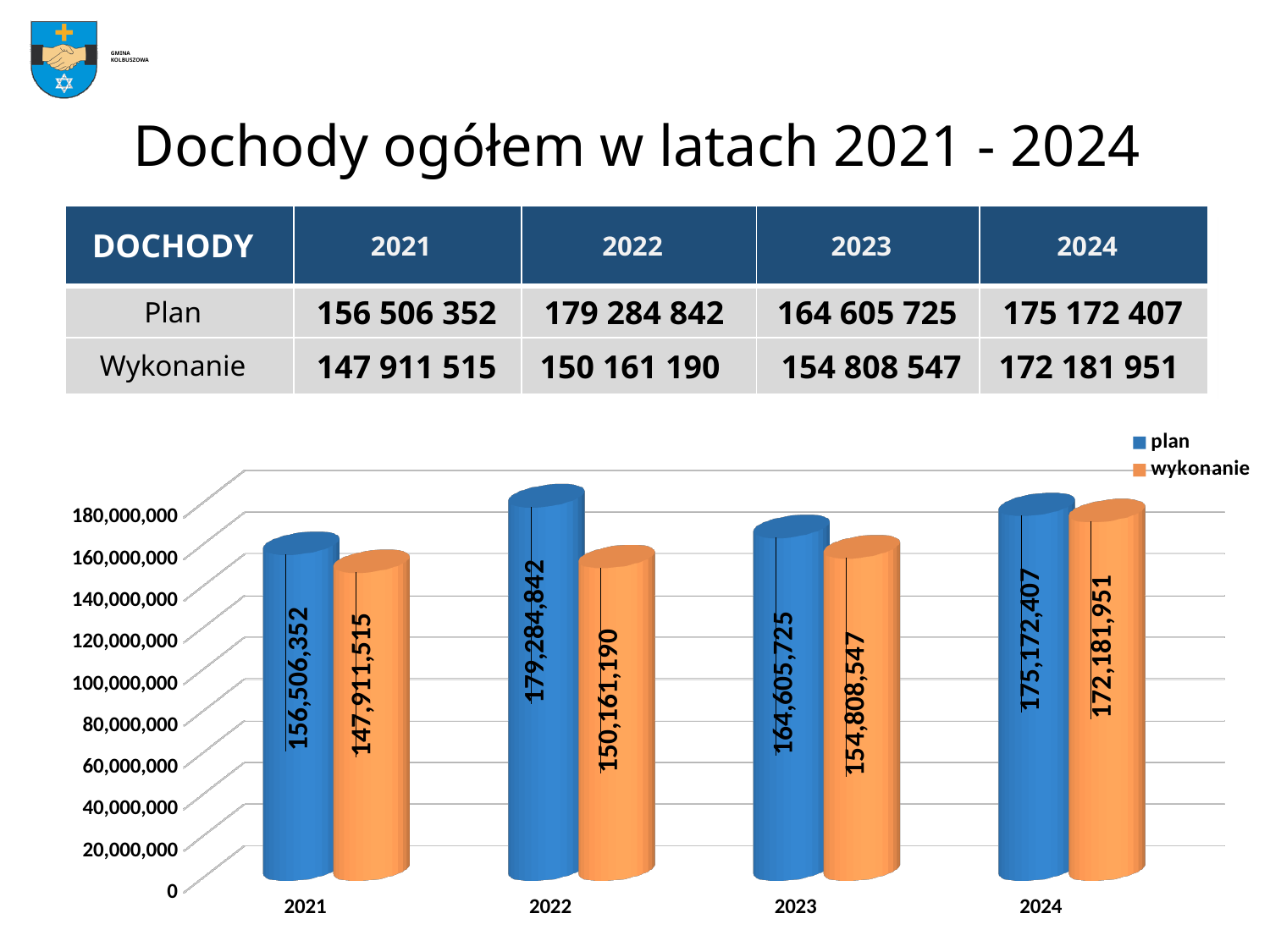
How many years are shown on the x axis of the chart? 4 How many series does the chart legend list? 2 Which year has the lowest wykonanie value? 2021 Which is larger in 2023, plan or wykonanie? plan Which year has the highest plan value? 2022 What is the difference between plan and wykonanie in 2024? 2,990,456 What is the plan value for 2022 in the chart? 179,284,842 What is the wykonanie value for 2023 in the chart? 154,808,547 Does the wykonanie series rise or fall from 2021 to 2024? rise Is the wykonanie value for 2022 greater or less than 160,000,000? less What is the difference between plan and wykonanie in 2021? 8,594,837 What is the wykonanie value for 2021 in the chart? 147,911,515